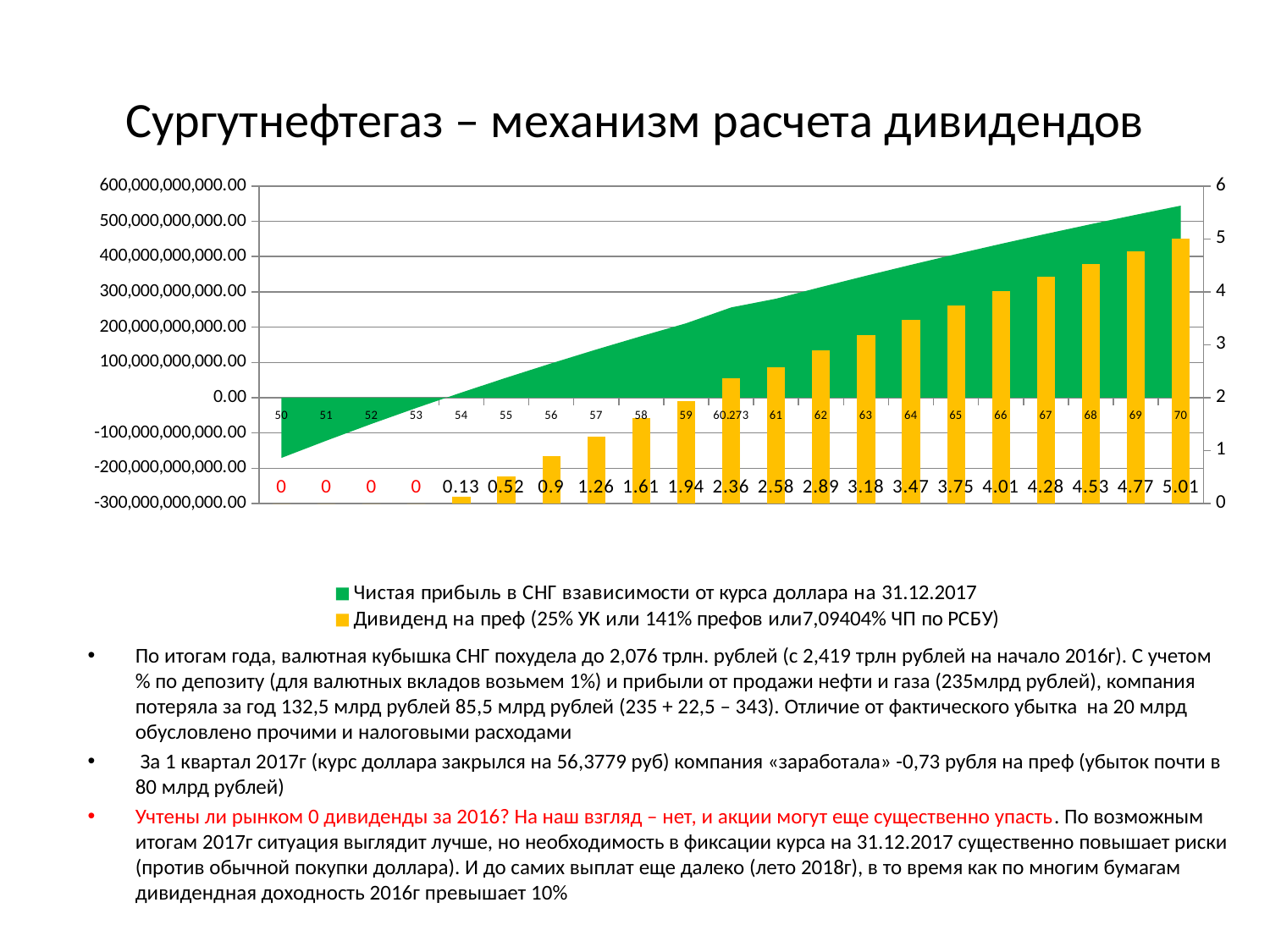
Is the net profit (green area) at a dollar rate of 70 greater or less than 500,000,000,000.00? greater At which dollar rate is the dividend per preferred share highest? 70 What is the dividend per preferred share (yellow bar) at a dollar rate of 70? 5.01 How many series does the legend list? 2 What is the dividend per preferred share shown at the 60.273 dollar rate? 2.36 Is the net profit (green area) at a dollar rate of 50 greater or less than 0.00? less Which is larger: the dividend per preferred share at 62 or at 58? 62 How many dollar-rate categories are shown on the x axis? 21 What kind of chart is this? Combined area and bar chart What is the dividend per preferred share shown at a dollar rate of 54? 0.13 Do the dividend per preferred share values rise or fall as the dollar rate increases along the x axis? rise What is the difference between the dividend per preferred share at 70 and at 69? 0.24